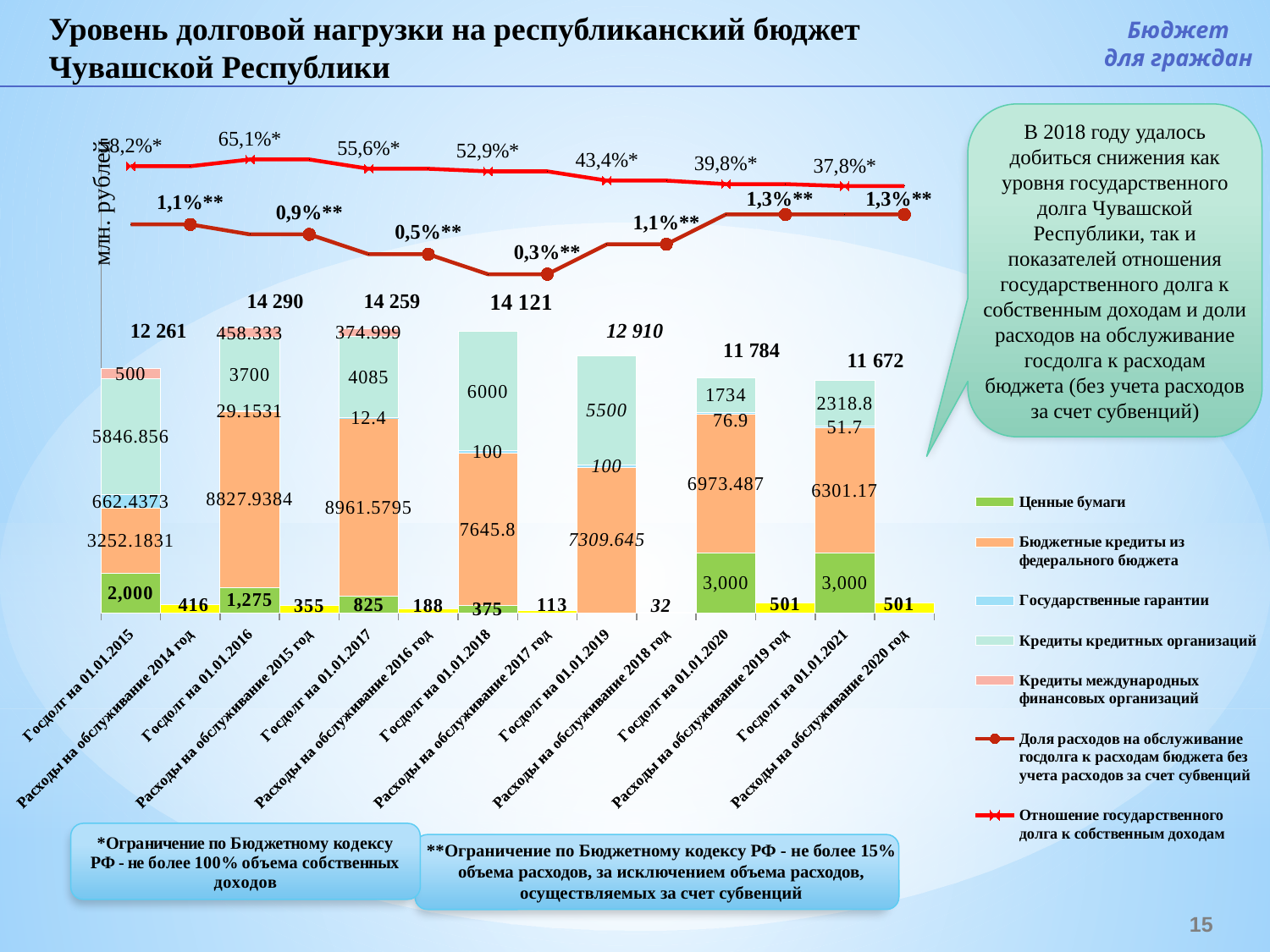
What is the difference between Расходы на обслуживание 2019 год and Расходы на обслуживание 2018 год? 469 What is the value for Расходы на обслуживание 2018 год? 32 What is the total state debt (госдолг) shown above the bar for Госдолг на 01.01.2016? 14 290 Which Госдолг bar has the lowest total value? Госдолг на 01.01.2021 Does the line Отношение государственного долга к собственным доходам rise or fall from left to right? fall How many series does the legend list? 7 Which is larger: Кредиты кредитных организаций for Госдолг на 01.01.2018 or for Госдолг на 01.01.2019? Госдолг на 01.01.2018 What is the value of Бюджетные кредиты из федерального бюджета for Госдолг на 01.01.2017? 8961.5795 What is the last value shown on the line Отношение государственного долга к собственным доходам (at 01.01.2021)? 37,8% Which Расходы на обслуживание category has the lowest value? Расходы на обслуживание 2018 год Which Госдолг bar has the highest total value? Госдолг на 01.01.2016 What is the value of Ценные бумаги for Госдолг на 01.01.2020? 3,000